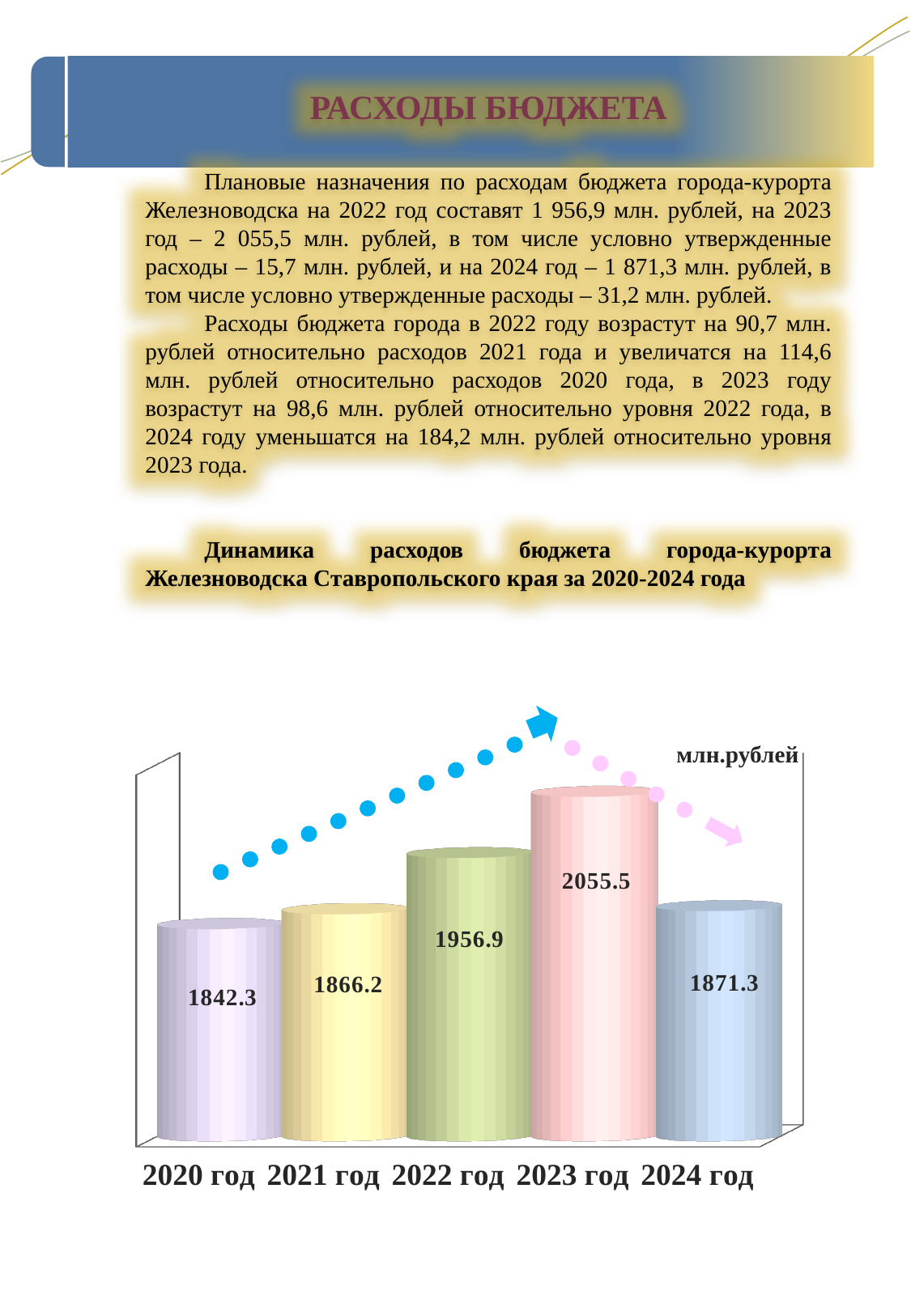
Which year has the highest value? 2023 год What kind of chart is shown? bar chart Which year has the lowest value? 2020 год Which is larger, the value for 2022 год or the value for 2024 год? 2022 год What is the value for 2020 год? 1842.3 How many years are shown on the chart? 5 What is the difference between the values for 2023 год and 2022 год? 98.6 What unit is shown in the top right corner of the chart? млн.рублей What is the value for 2022 год? 1956.9 Do the values rise or fall from 2020 год to 2023 год? rise What is the value for 2024 год? 1871.3 What is the difference between the values for 2021 год and 2020 год? 23.9